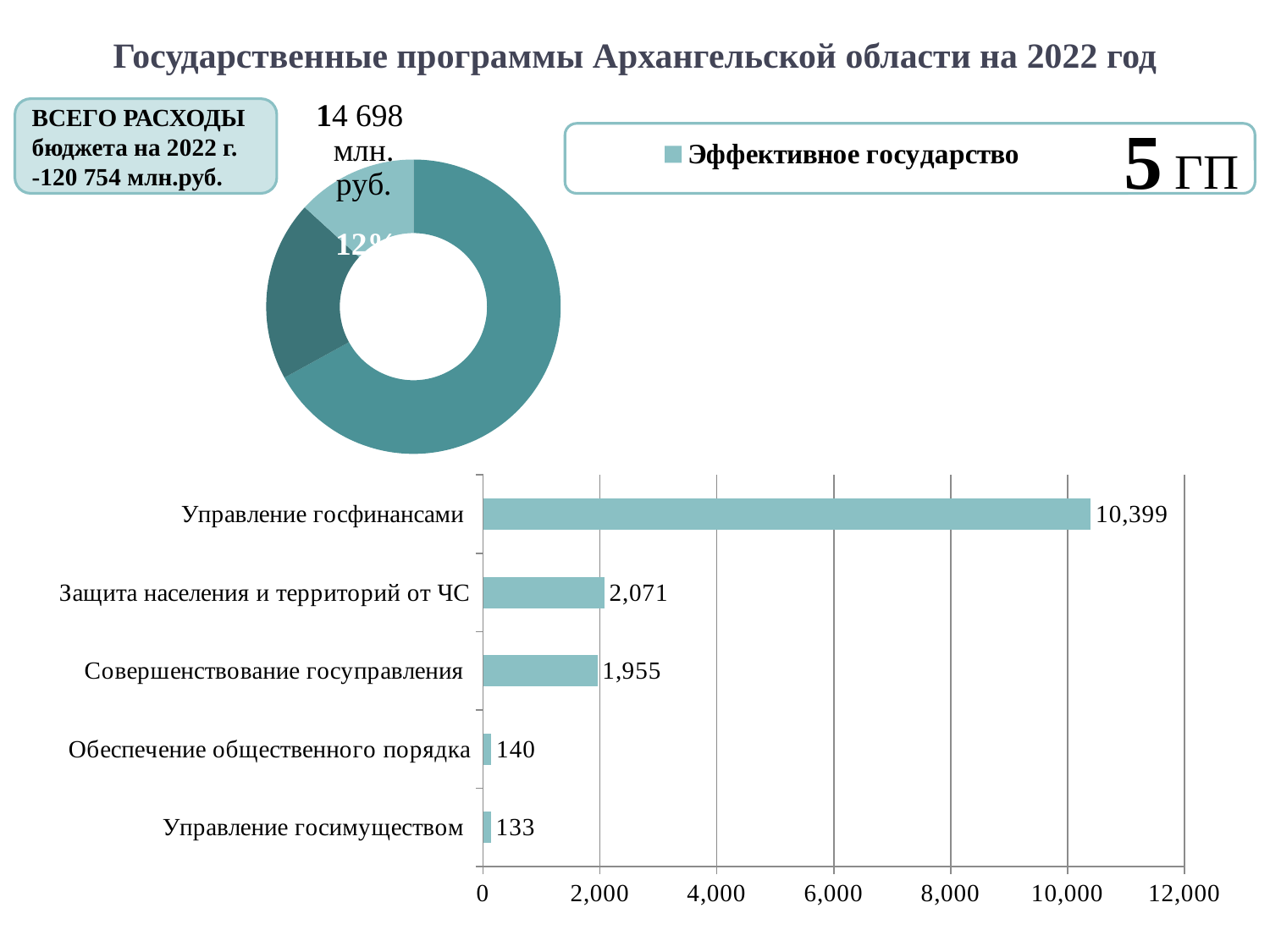
In the lower bar chart, what is the difference between Управление госфинансами and Защита населения и территорий от ЧС? 8,328 In the lower bar chart, what is the value for Управление госимуществом? 133 In the lower bar chart, which category has the highest value? Управление госфинансами In the lower bar chart, what is the value for Управление госфинансами? 10,399 What kind of chart is the lower chart on the slide? bar chart In the lower bar chart, what is the value for Защита населения и территорий от ЧС? 2,071 How many categories are shown in the lower bar chart? 5 In the lower bar chart, which is larger: Обеспечение общественного порядка or Управление госимуществом? Обеспечение общественного порядка In the lower bar chart, which category has the lowest value? Управление госимуществом What entry does the legend next to the upper doughnut chart list? Эффективное государство What kind of chart is the upper chart on the slide? doughnut chart In the lower bar chart, what is the value for Совершенствование госуправления? 1,955